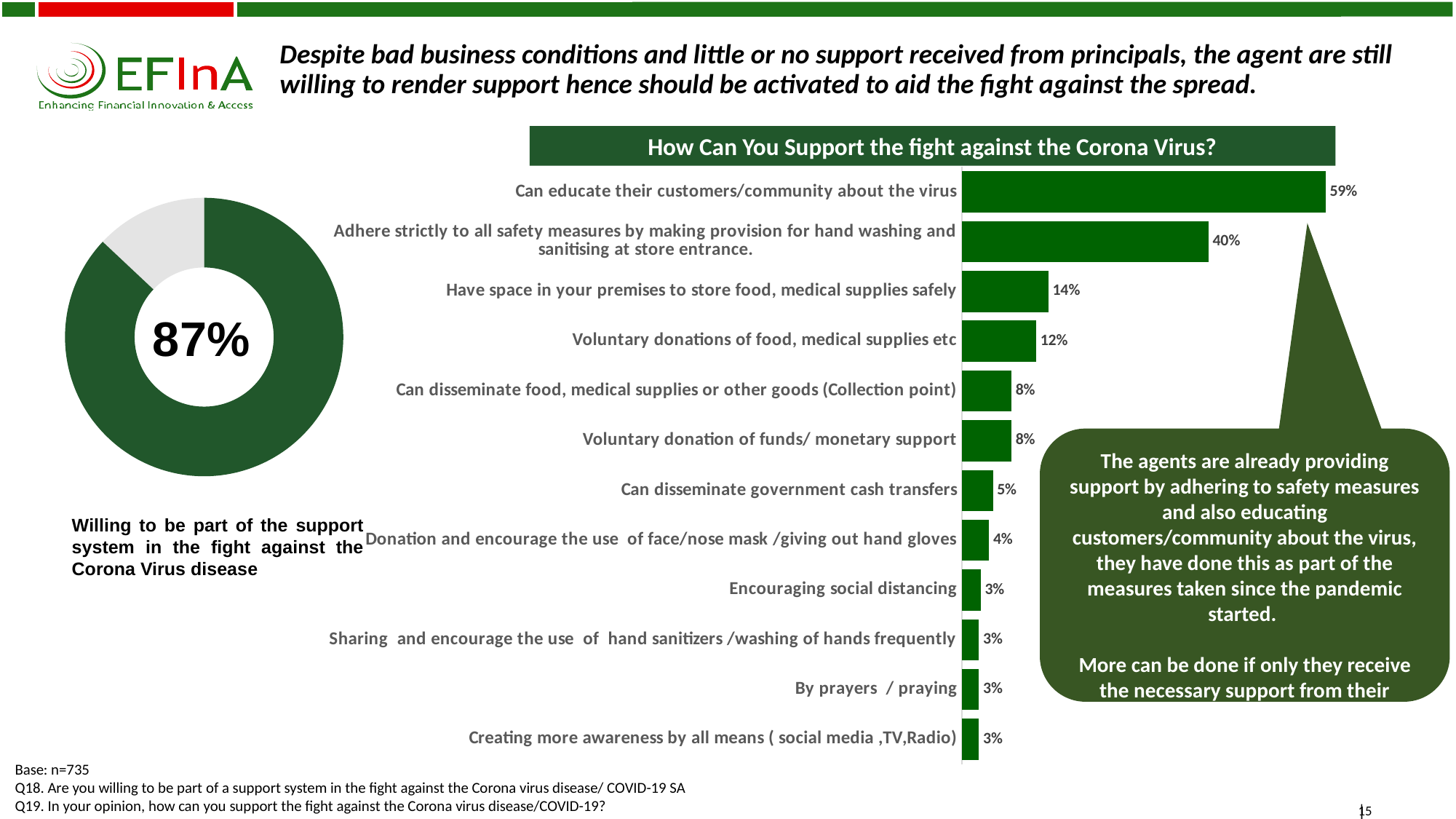
In the bar chart 'How Can You Support the fight against the Corona Virus?', what is the difference between 'Can educate their customers/community about the virus' and 'Adhere strictly to all safety measures by making provision for hand washing and sanitising at store entrance.'? 19% In the bar chart 'How Can You Support the fight against the Corona Virus?', what is the value for 'Have space in your premises to store food, medical supplies safely'? 14% In the bar chart 'How Can You Support the fight against the Corona Virus?', which is larger: 'Voluntary donations of food, medical supplies etc' or 'Voluntary donation of funds/ monetary support'? Voluntary donations of food, medical supplies etc How many categories are shown in the bar chart 'How Can You Support the fight against the Corona Virus?'? 12 What kind of chart is 'How Can You Support the fight against the Corona Virus?'? Bar chart What is the title of the bar chart on the right of the slide? How Can You Support the fight against the Corona Virus? What kind of chart is the chart on the left of the slide showing 87%? Donut chart In the bar chart 'How Can You Support the fight against the Corona Virus?', what is the value for 'Can educate their customers/community about the virus'? 59% In the bar chart 'How Can You Support the fight against the Corona Virus?', what is the value for 'Donation and encourage the use of face/nose mask /giving out hand gloves'? 4% In the donut chart on the left of the slide, what percentage is willing to be part of the support system in the fight against the Corona Virus disease? 87% In the bar chart 'How Can You Support the fight against the Corona Virus?', which category has the highest value? Can educate their customers/community about the virus In the bar chart 'How Can You Support the fight against the Corona Virus?', what is the value for 'Can disseminate government cash transfers'? 5%